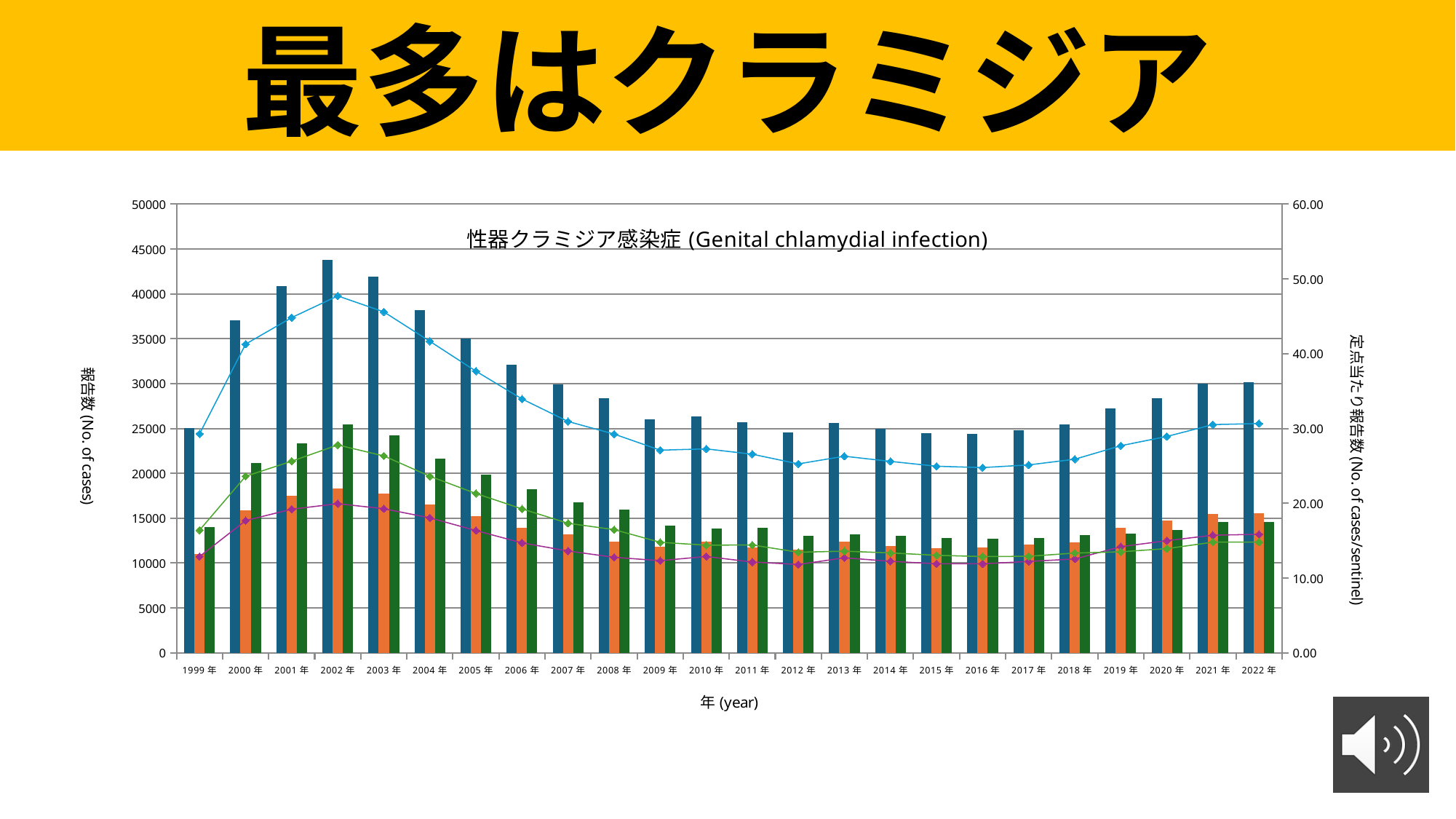
Do the dark blue bars rise or fall from 1999 年 to 2002 年? rise In which year does the blue line reach its highest point? 2002 年 In which year is the dark blue bar the tallest? 2002 年 What is the label of the left vertical axis? 報告数 (No. of cases) What kind of chart is shown on the slide? Combined bar and line chart Is the dark blue bar for 1999 年 greater or less than 30000? less What is the title of the chart? 性器クラミジア感染症 (Genital chlamydial infection) Is the dark blue bar for 2002 年 greater or less than 40000? greater How many years are shown on the x axis of the chart? 24 Which year has the taller dark blue bar, 2002 年 or 2022 年? 2002 年 Is the blue line value for 2016 年 greater or less than 30.00 on the right axis? less